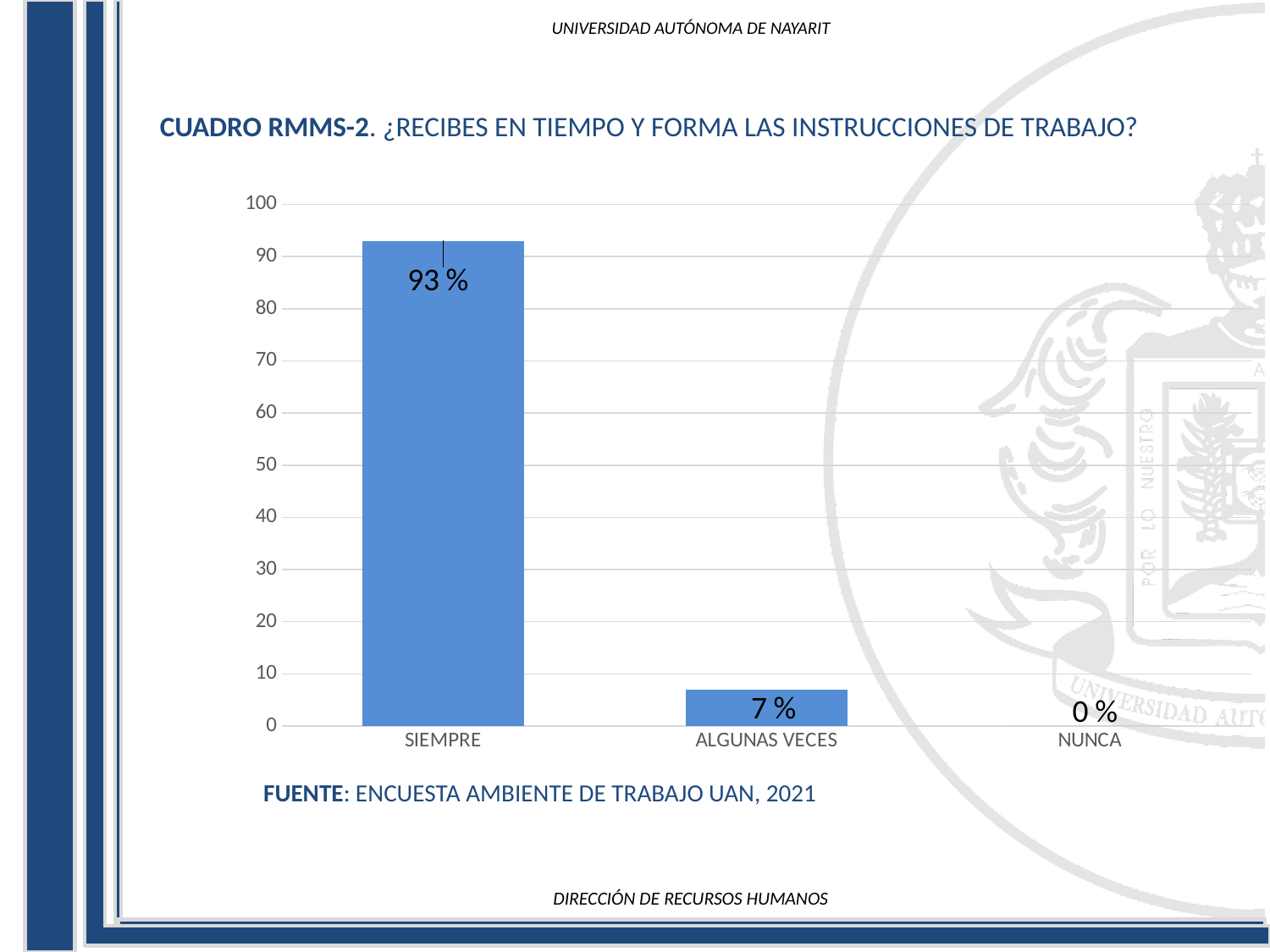
Which category has the highest value? SIEMPRE Which category has the lowest value? NUNCA What is the value for SIEMPRE? 93 % What is the difference between the values for SIEMPRE and ALGUNAS VECES? 86 % What kind of chart is shown on the slide? bar chart What is the value for ALGUNAS VECES? 7 % What is the value for NUNCA? 0 % Is the value for ALGUNAS VECES greater or less than 10? less Is the value for SIEMPRE greater or less than 90? greater How many categories are shown on the x axis? 3 What is the source cited below the chart? ENCUESTA AMBIENTE DE TRABAJO UAN, 2021 Which is larger, the value for ALGUNAS VECES or the value for NUNCA? ALGUNAS VECES